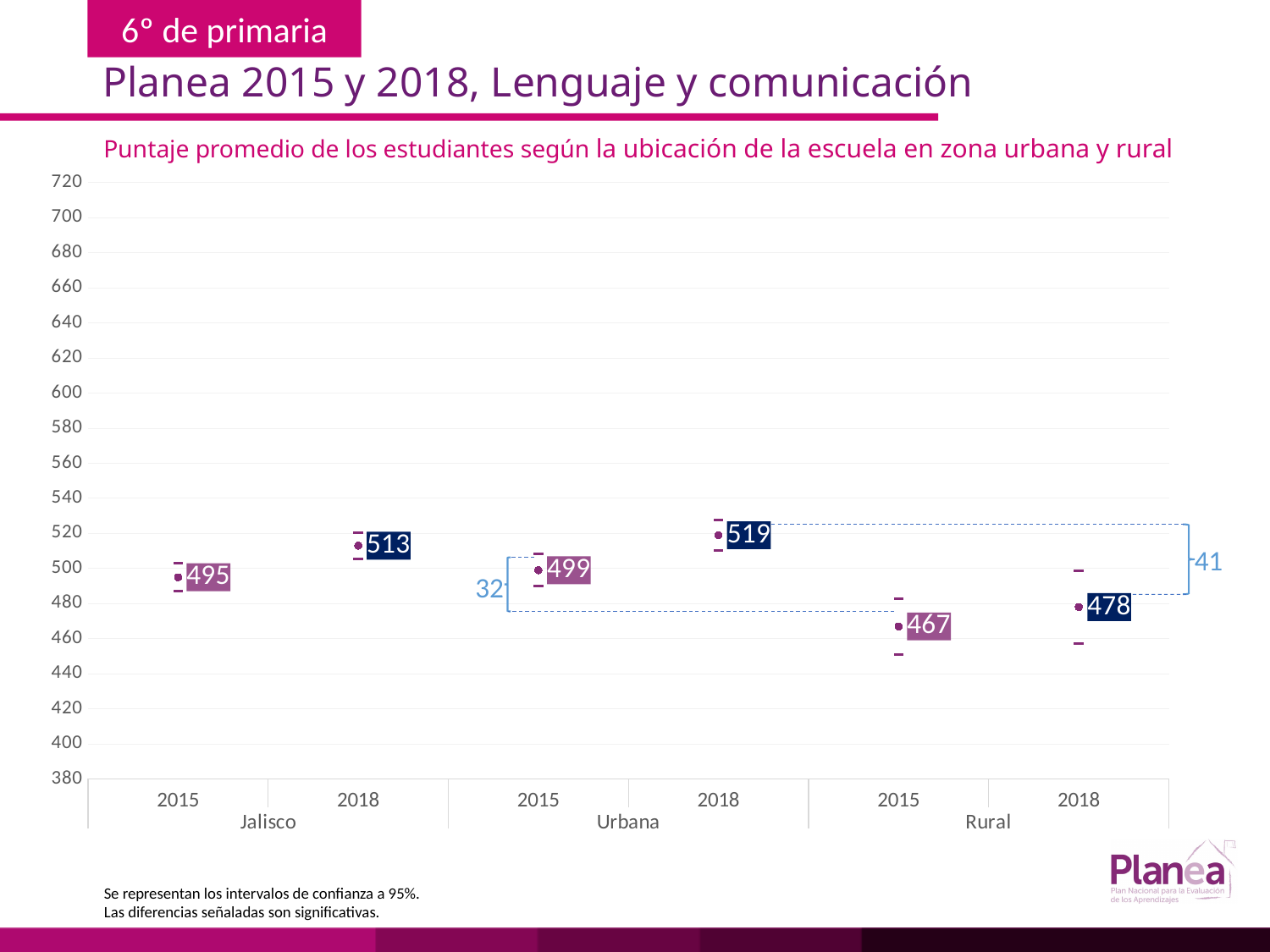
What is the average score for Jalisco in 2015? 495 How many data points are plotted on the chart? 6 What is the title of the chart? Puntaje promedio de los estudiantes según la ubicación de la escuela en zona urbana y rural Which is larger, the 2015 score for Urbana or the 2015 score for Jalisco? Urbana 2015 Did the Rural average score rise or fall from 2015 to 2018? rise Which group and year has the highest average score? Urbana 2018 What is the average score for Urbana in 2018? 519 What is the difference between the Urbana and Rural average scores in 2018? 41 By how many points did the Jalisco average score change from 2015 to 2018? 18 Is the 2018 Rural score greater or less than 500? less Which group and year has the lowest average score? Rural 2015 What is the average score for Rural in 2015? 467